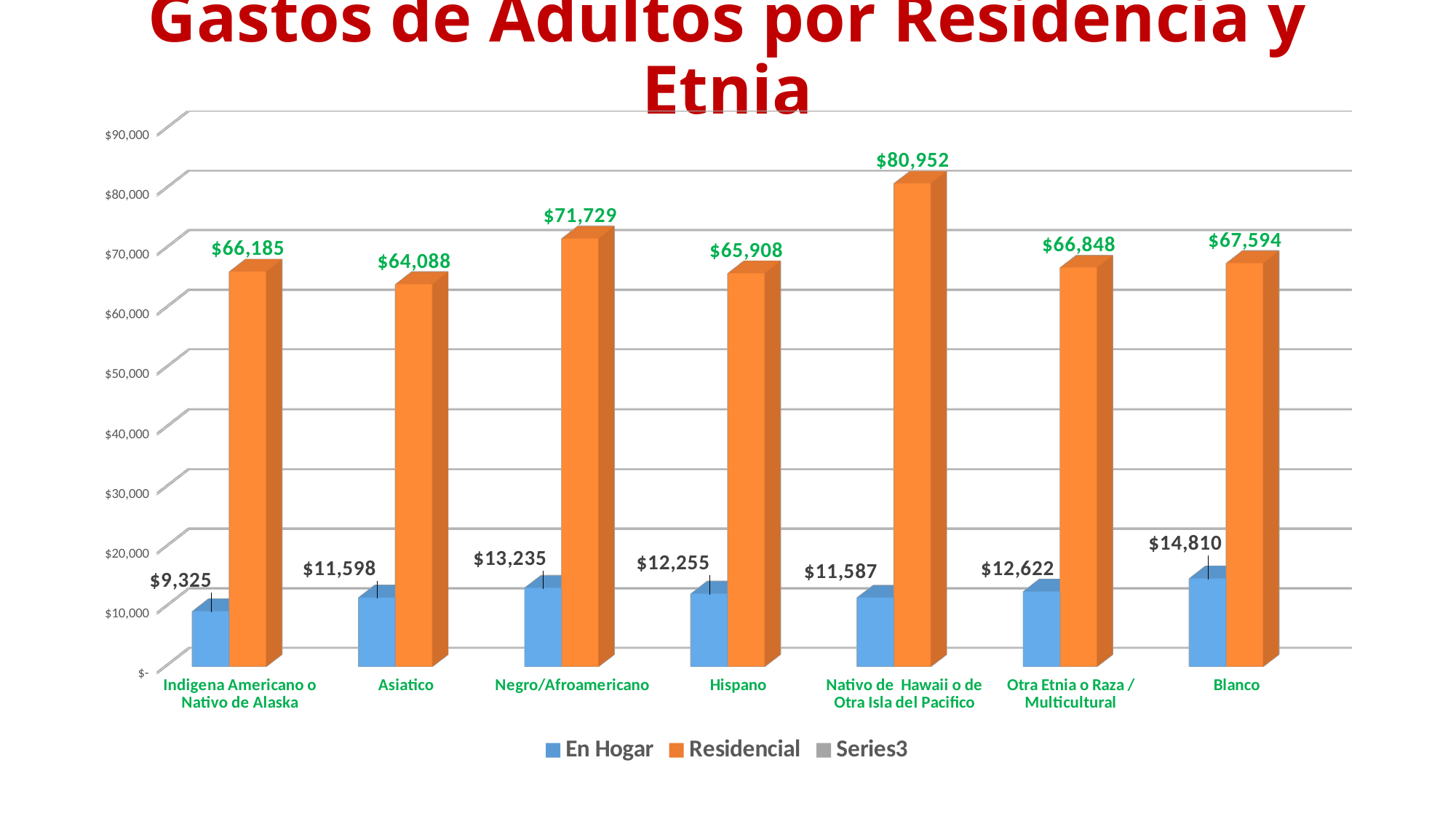
What type of chart is shown on the slide? Bar chart How many categories are shown on the x axis? 7 What is the Residencial value for Nativo de Hawaii o de Otra Isla del Pacifico? $80,952 Which category has the highest Residencial value? Nativo de Hawaii o de Otra Isla del Pacifico What is the difference between the Residencial and En Hogar values for Blanco? $52,784 Which is larger, the En Hogar value for Hispano or the En Hogar value for Asiatico? Hispano Which category has the lowest En Hogar value? Indigena Americano o Nativo de Alaska What is the En Hogar value for Blanco? $14,810 What is the En Hogar value for Negro/Afroamericano? $13,235 What is the difference between the Residencial values for Nativo de Hawaii o de Otra Isla del Pacifico and Asiatico? $16,864 Which category has the lowest Residencial value? Asiatico How many series does the legend list? 3